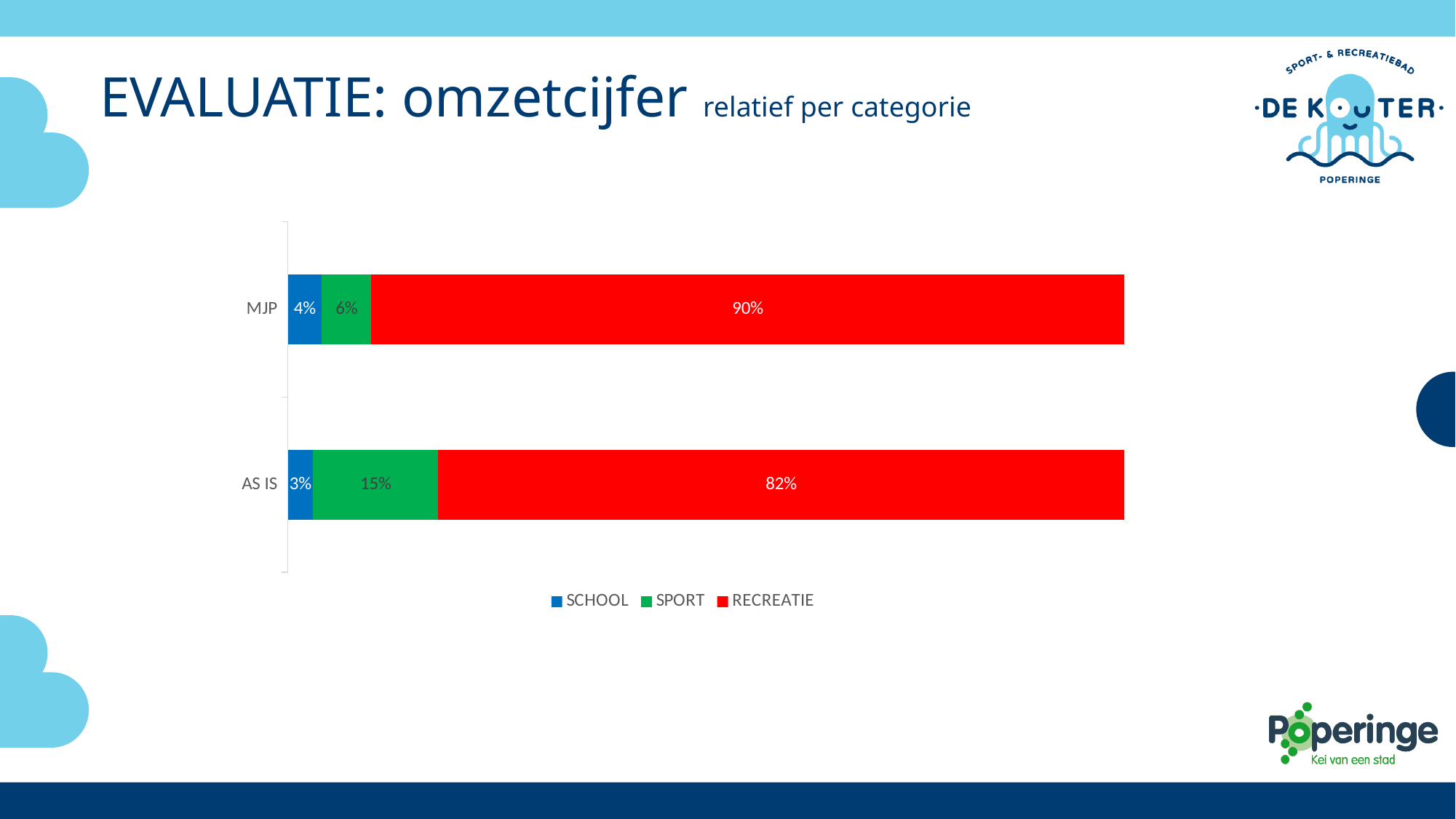
What is the SPORT value for AS IS? 15% Which series has the smallest share in the AS IS bar? SCHOOL What is the difference between the SPORT values for AS IS and MJP? 9% How many series does the legend list? 3 Which series has the largest share in the MJP bar? RECREATIE How many categories are shown on the y axis? 2 What kind of chart is shown on the slide? Stacked bar chart What is the RECREATIE value for AS IS? 82% What is the RECREATIE value for MJP? 90% What is the SCHOOL value for AS IS? 3% Which is larger, the RECREATIE value for MJP or for AS IS? MJP What is the SCHOOL value for MJP? 4%